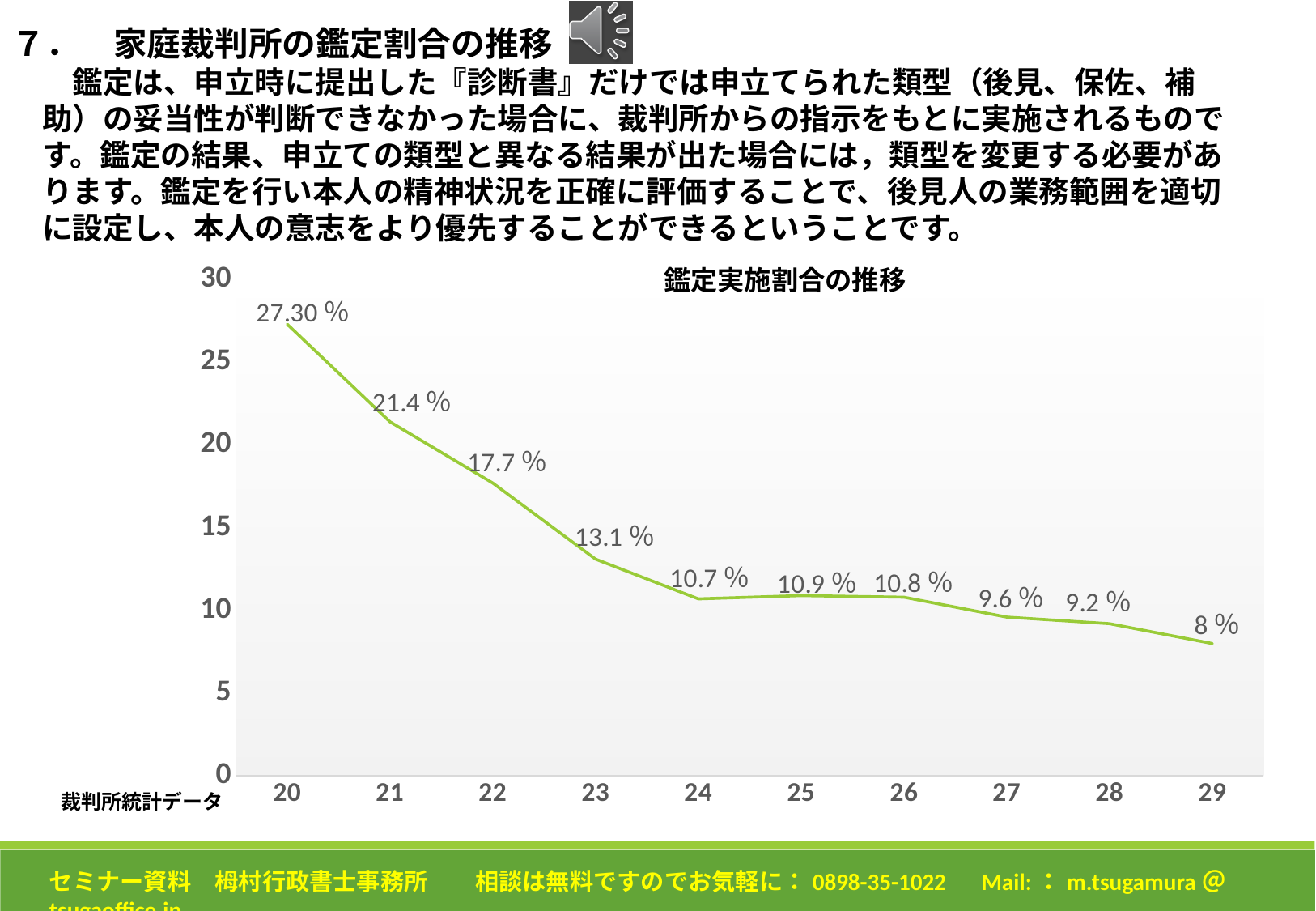
What is the value for 26 in the 鑑定実施割合の推移 chart? 10.8 % How many data points are plotted in the 鑑定実施割合の推移 chart? 10 What kind of chart is the 鑑定実施割合の推移 chart? Line chart What is the difference between the values for 20 and 21 in the 鑑定実施割合の推移 chart? 5.9 % What is the value for 20 in the 鑑定実施割合の推移 chart? 27.30 % What is the value for 23 in the 鑑定実施割合の推移 chart? 13.1 % Is the value for 21 in the 鑑定実施割合の推移 chart greater or less than 20? greater Which year has the lowest value in the 鑑定実施割合の推移 chart? 29 Do the values in the 鑑定実施割合の推移 chart generally rise or fall from 20 to 29? Fall Which year has the highest value in the 鑑定実施割合の推移 chart? 20 What is the value for 29 in the 鑑定実施割合の推移 chart? 8 % Which is larger in the 鑑定実施割合の推移 chart, the value for 22 or the value for 24? 22